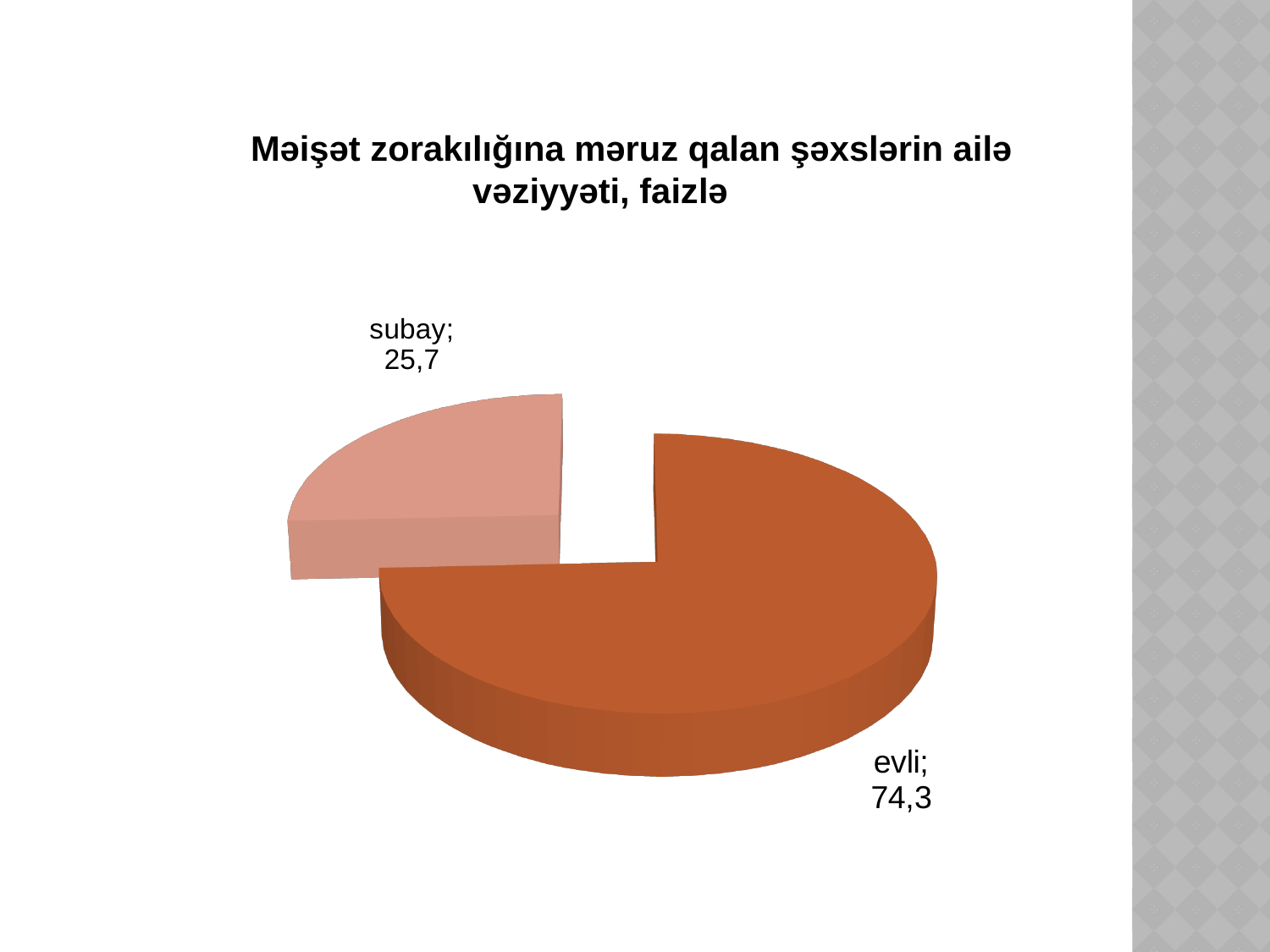
Which category has the largest share of the pie? evli What is the total of the two slice values shown? 100 Which category has the smallest share of the pie? subay How many slices does the pie chart have? 2 What is the value for the "subay" slice? 25,7 Which is larger, the value for "evli" or the value for "subay"? evli What kind of chart is shown on the slide? pie chart What is the difference between the values for "evli" and "subay"? 48,6 What is the value for the "evli" slice? 74,3 Which slice is shown in the lighter pink colour? subay What is the title of the chart? Məişət zorakılığına məruz qalan şəxslərin ailə vəziyyəti, faizlə